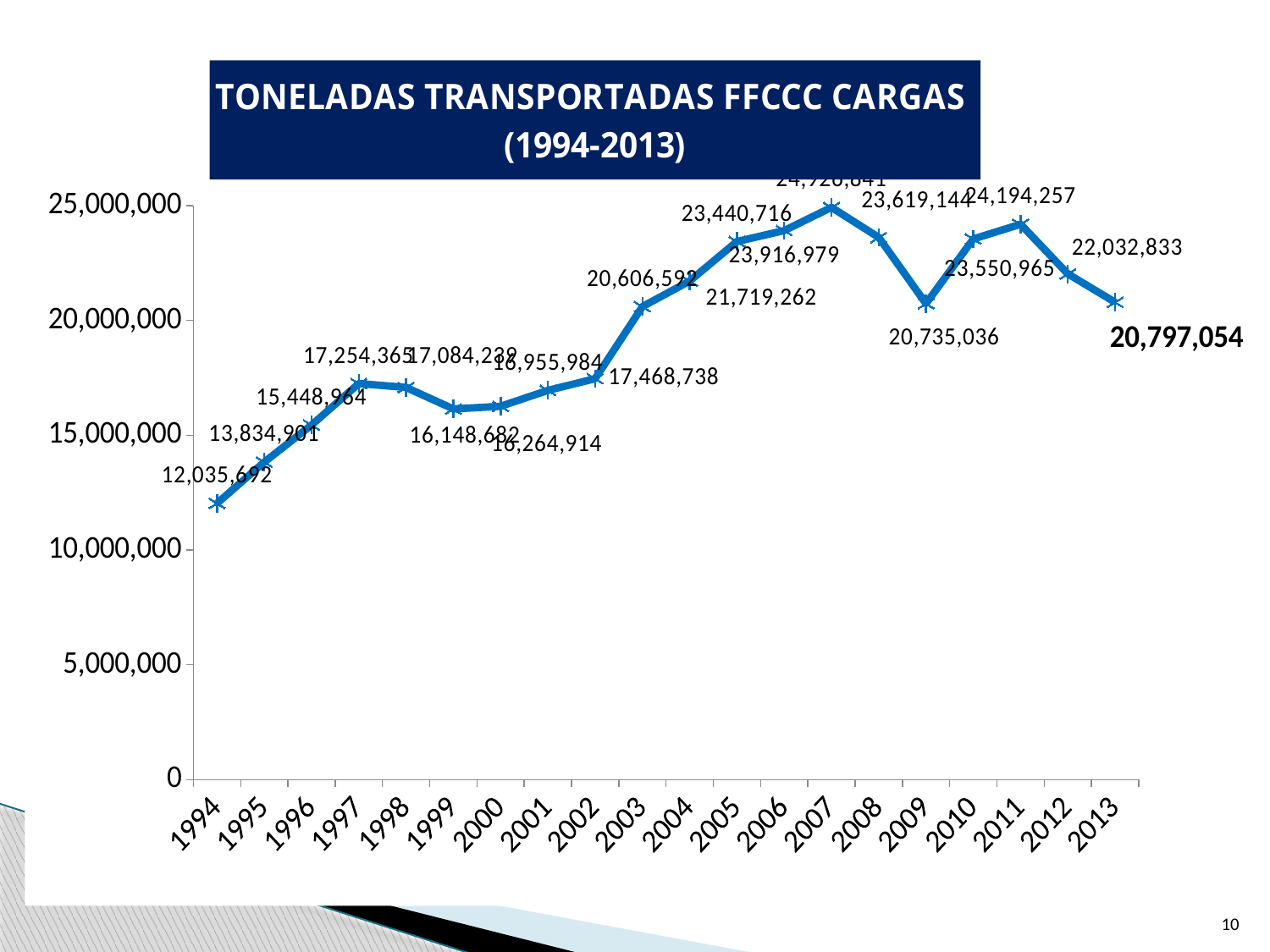
What value is shown for 2011? 24,194,257 What is the difference between the values for 2012 and 2013? 1,235,779 What kind of chart is shown on the slide? line chart Which year has the larger value, 2010 or 2012? 2010 Do the values rise or fall from 1994 to 1997? rise What value is shown for 2013? 20,797,054 What value is shown for 1994? 12,035,692 How many years are plotted on the x axis? 20 What value is shown for 2009? 20,735,036 Which year has the lowest value? 1994 Is the value for 2004 greater or less than 20,000,000? greater Which year has the highest value? 2007